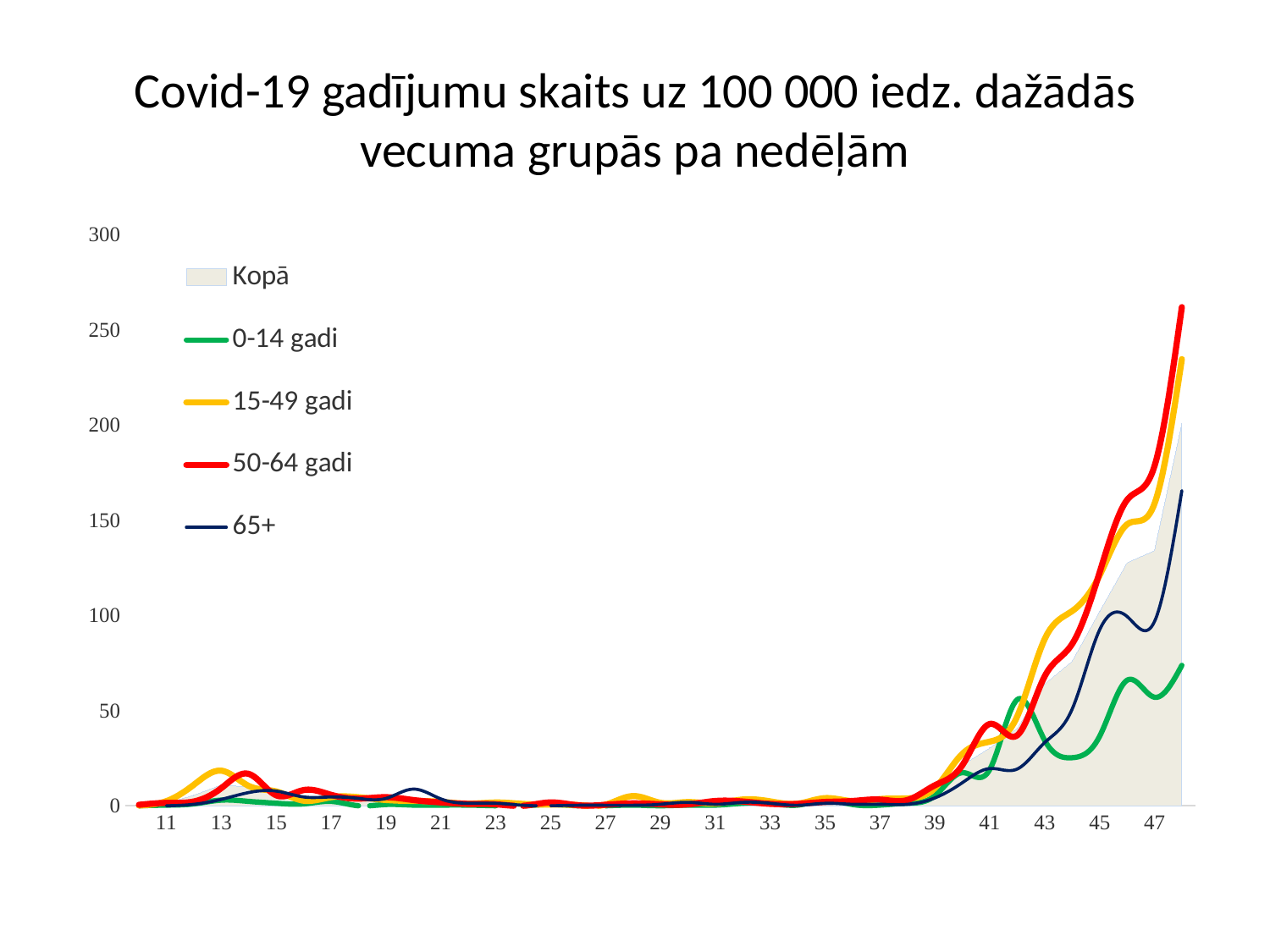
Is the value for 0-14 gadi at week 48 greater or less than 100? less Which series is drawn as a shaded area rather than a line? Kopā Is the value for 15-49 gadi at week 48 greater or less than 200? greater Which age group has the highest value at the last week shown (week 48)? 50-64 gadi Which age group has the lowest value at the last week shown (week 48)? 0-14 gadi At week 48, which is larger: the value for 65+ or the value for 0-14 gadi? 65+ Is the value for 65+ at week 48 greater or less than 150? greater How many series does the legend list? 5 What kind of chart is shown on the slide? combination area and line chart Do the values for 50-64 gadi rise or fall between week 39 and week 48? rise What is the title of the chart? Covid-19 gadījumu skaits uz 100 000 iedz. dažādās vecuma grupās pa nedēļām